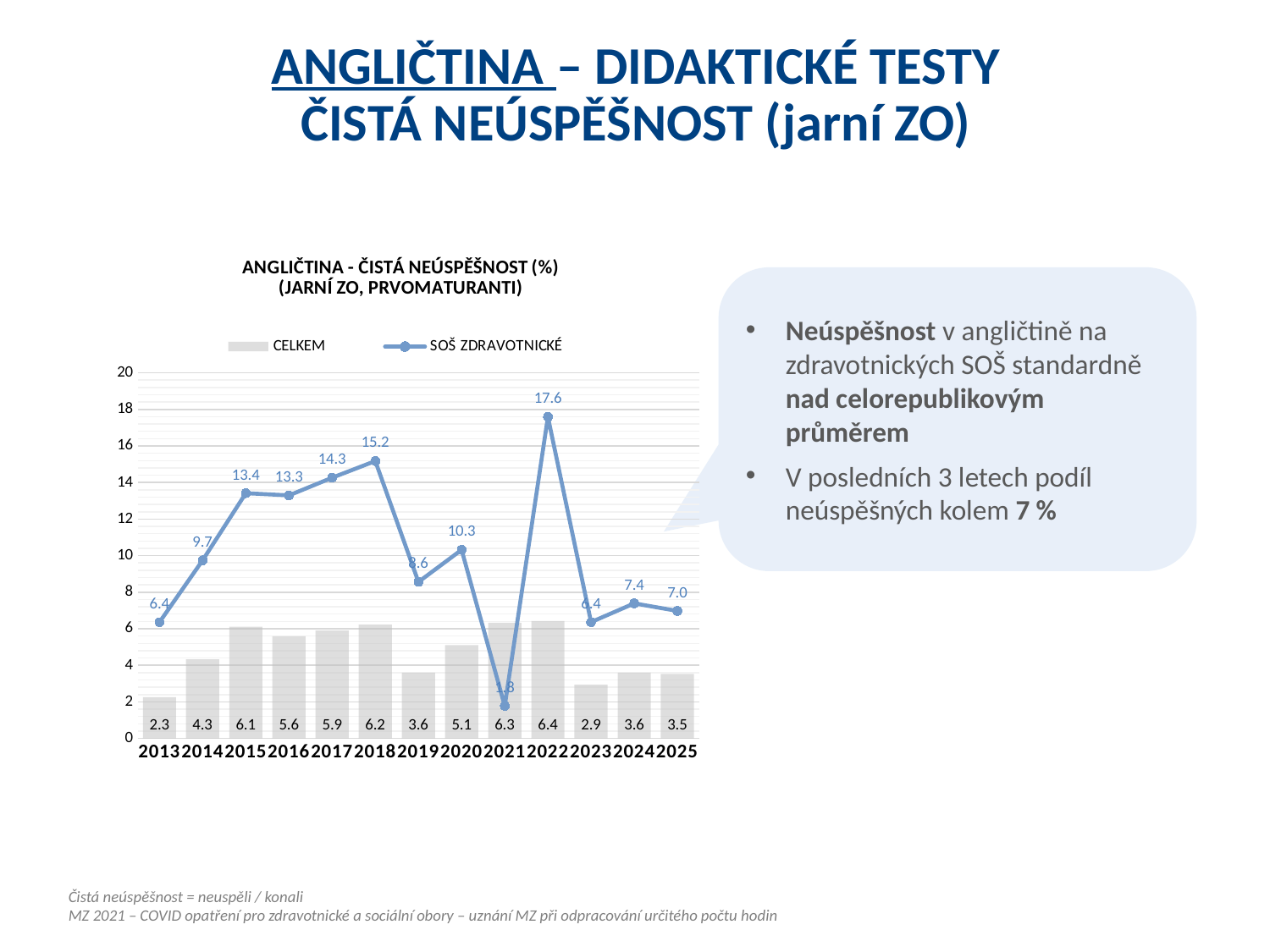
In which year is the SOŠ ZDRAVOTNICKÉ value highest? 2022 How many series does the legend list? 2 What kind of chart is this? Combined bar and line chart Does the SOŠ ZDRAVOTNICKÉ value rise or fall from 2013 to 2018? rise Is the SOŠ ZDRAVOTNICKÉ value for 2017 greater or less than 12? greater How many years are shown on the x axis? 13 What is the difference between the SOŠ ZDRAVOTNICKÉ value and the CELKEM value in 2022? 11.2 What is the CELKEM value for 2022? 6.4 What is the SOŠ ZDRAVOTNICKÉ value for 2025? 7.0 Which is larger in 2015: the CELKEM value or the SOŠ ZDRAVOTNICKÉ value? SOŠ ZDRAVOTNICKÉ In which year is the CELKEM value lowest? 2013 What is the SOŠ ZDRAVOTNICKÉ value for 2018? 15.2